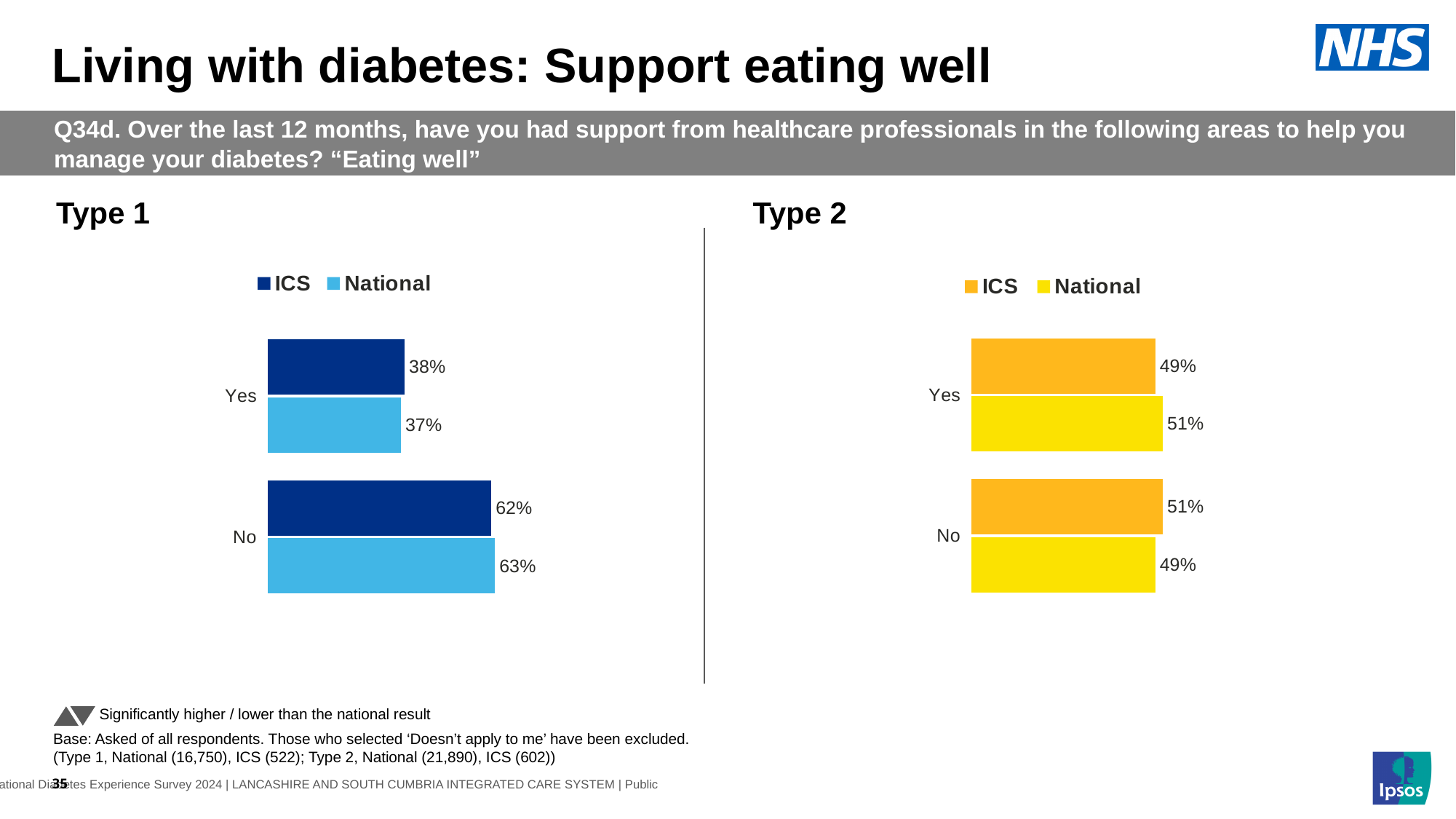
In the Type 2 chart, what is the ICS value for Yes? 49% In the Type 1 chart, what is the difference between the ICS values for No and Yes? 24 percentage points In the Type 1 chart, what is the National value for No? 63% What type of chart is the Type 2 chart? Bar chart In the Type 1 chart, how many categories are shown? 2 In the Type 2 chart, how many series does the legend list? 2 In the Type 1 chart, which category has the lowest National value? Yes In the Type 2 chart, what is the difference between the National values for Yes and No? 2 percentage points In the Type 1 chart, what is the ICS value for Yes? 38% In the Type 2 chart, what is the ICS value for No? 51% In the Type 2 chart, what is the National value for Yes? 51% In the Type 1 chart, which category has the highest ICS value? No